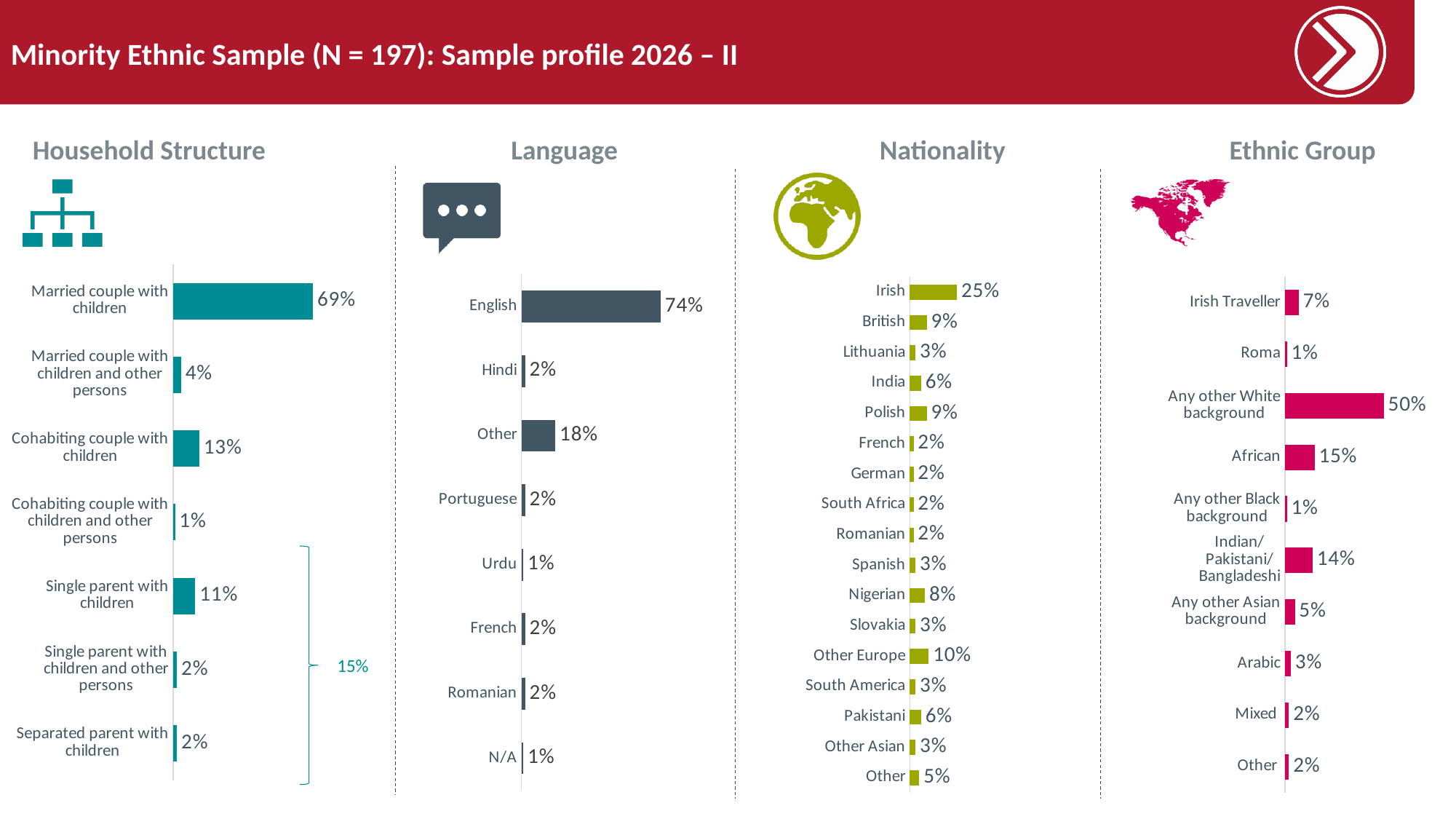
How many categories are shown in the Language chart? 8 What type of chart is the Ethnic Group chart? Bar chart In the Nationality chart, which category has the highest value? Irish In the Household Structure chart, what is the difference between Cohabiting couple with children and Single parent with children? 2% In the Nationality chart, what is the difference between Irish and British? 16% In the Ethnic Group chart, what percentage is shown for Any other White background? 50% In the Household Structure chart, what percentage is shown for Married couple with children? 69% In the Language chart, which is larger, English or Other? English In the Nationality chart, what percentage is shown for Other Europe? 10% In the Ethnic Group chart, which is larger, African or Indian/Pakistani/Bangladeshi? African In the Household Structure chart, which category has the highest value? Married couple with children In the Language chart, what percentage is shown for Other? 18%